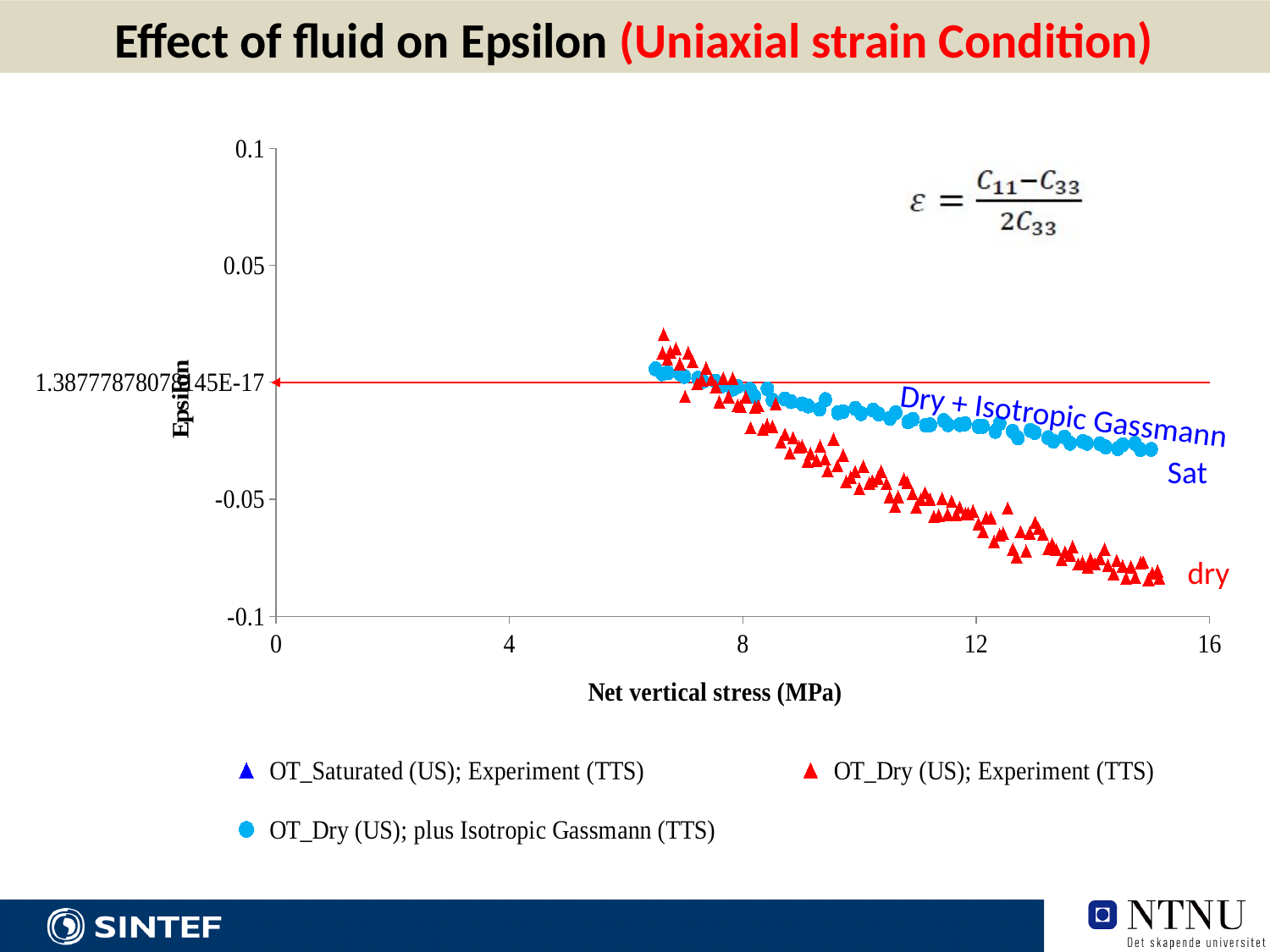
As net vertical stress increases, do the values of the 'Dry + Isotropic Gassmann' series rise or fall? Fall What is the title of the chart's x axis? Net vertical stress (MPa) What is the title of the chart's y axis? Epsilon Is the Epsilon value for the 'dry' series at a net vertical stress of 12 MPa greater or less than 0? less What kind of chart is shown on the slide? Scatter chart As net vertical stress increases, do the values of the 'dry' series rise or fall? Fall How many series does the chart legend list? 3 What is the maximum value shown on the chart's x axis? 16 Is the Epsilon value for the 'dry' series at a net vertical stress of 15 MPa greater or less than -0.05? less Is the Epsilon value for the 'Dry + Isotropic Gassmann' series at a net vertical stress of 15 MPa greater or less than -0.05? greater At a net vertical stress of 12 MPa, which series has the higher Epsilon value: 'dry' or 'Dry + Isotropic Gassmann'? Dry + Isotropic Gassmann